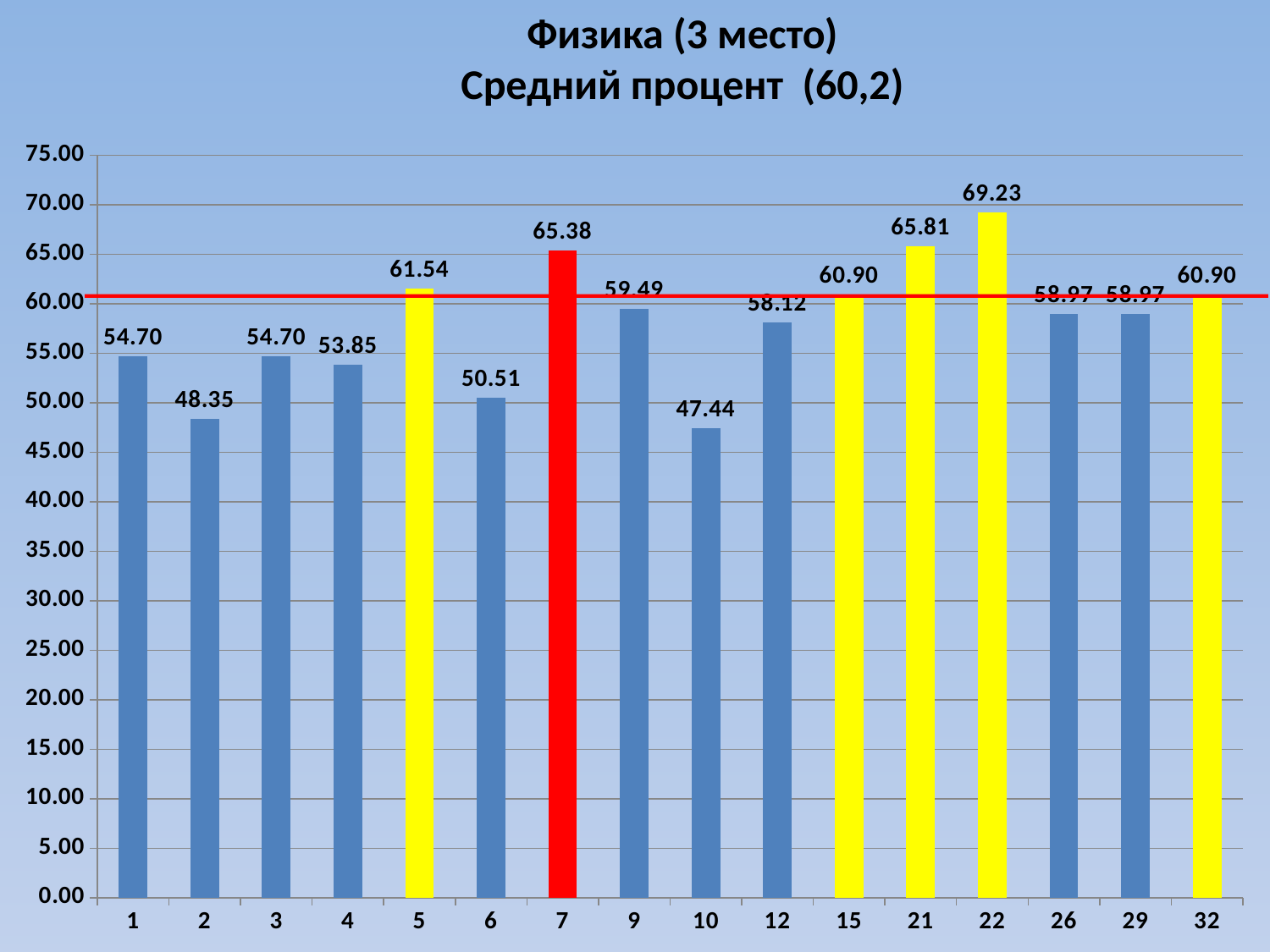
What is the difference between the values for category 22 and category 10? 21.79 Which is larger, the value for category 5 or the value for category 21? 21 Which category's bar is coloured red? 7 What is the difference between the values for category 7 and category 6? 14.87 What is the value for category 7? 65.38 Is the value for category 2 greater or less than 50.00? less How many bars are plotted in the chart? 16 Which category has the highest value? 22 What is the value for category 22? 69.23 Which category has the lowest value? 10 What is the value for category 10? 47.44 What type of chart is shown on the slide? bar chart